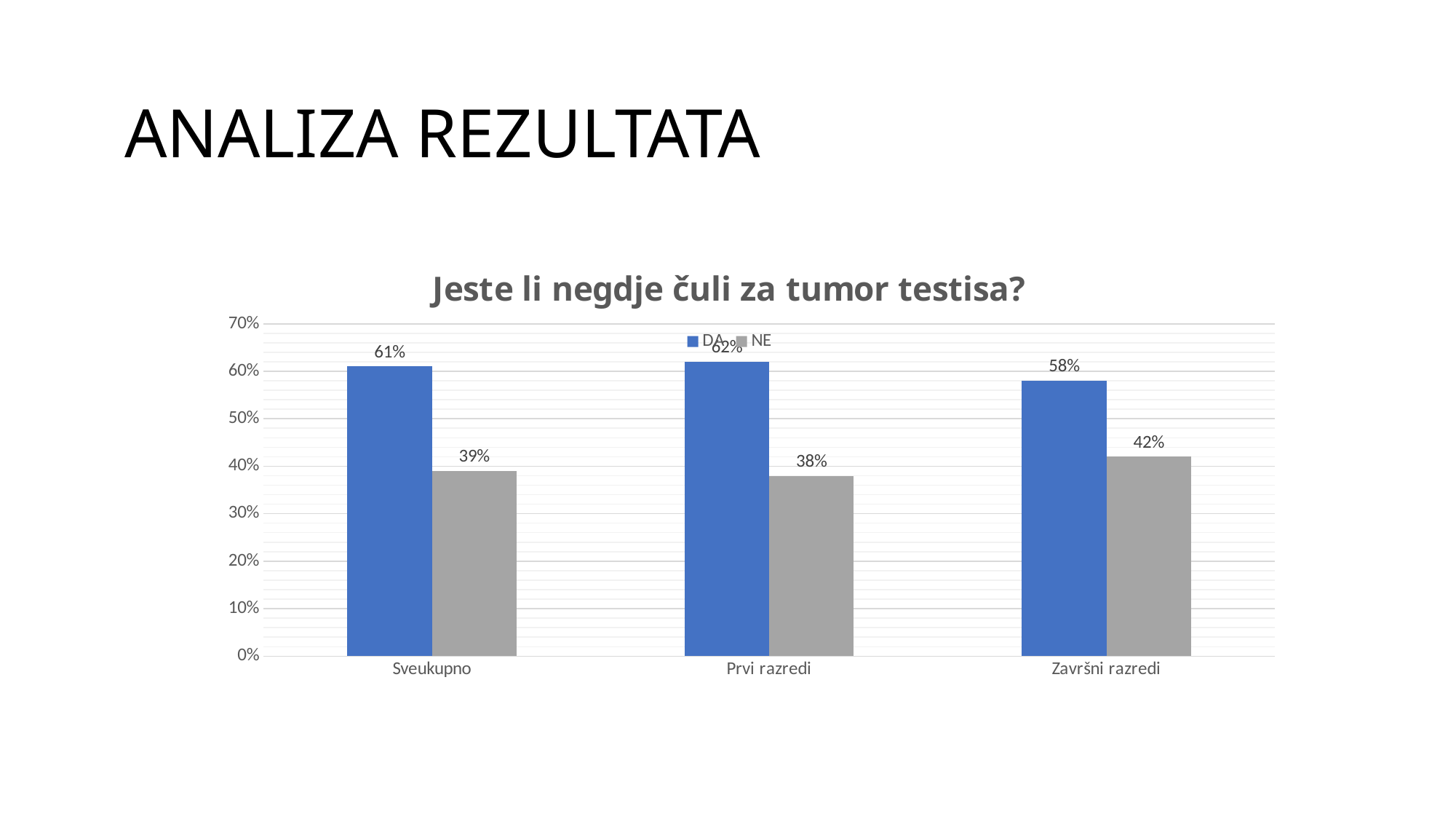
What is the difference between the DA and NE values for Sveukupno? 22% What is the value for DA in the Završni razredi category? 58% How many categories are shown on the x axis? 3 What kind of chart is shown on the slide? bar chart Which category has the lowest NE value? Prvi razredi What is the value for NE in the Prvi razredi category? 38% What is the value for DA in the Sveukupno category? 61% What is the value for NE in the Završni razredi category? 42% Which category has the highest DA value? Prvi razredi Which is larger for Završni razredi, DA or NE? DA Is the NE value for Sveukupno greater or less than 40%? less How many series does the legend list? 2